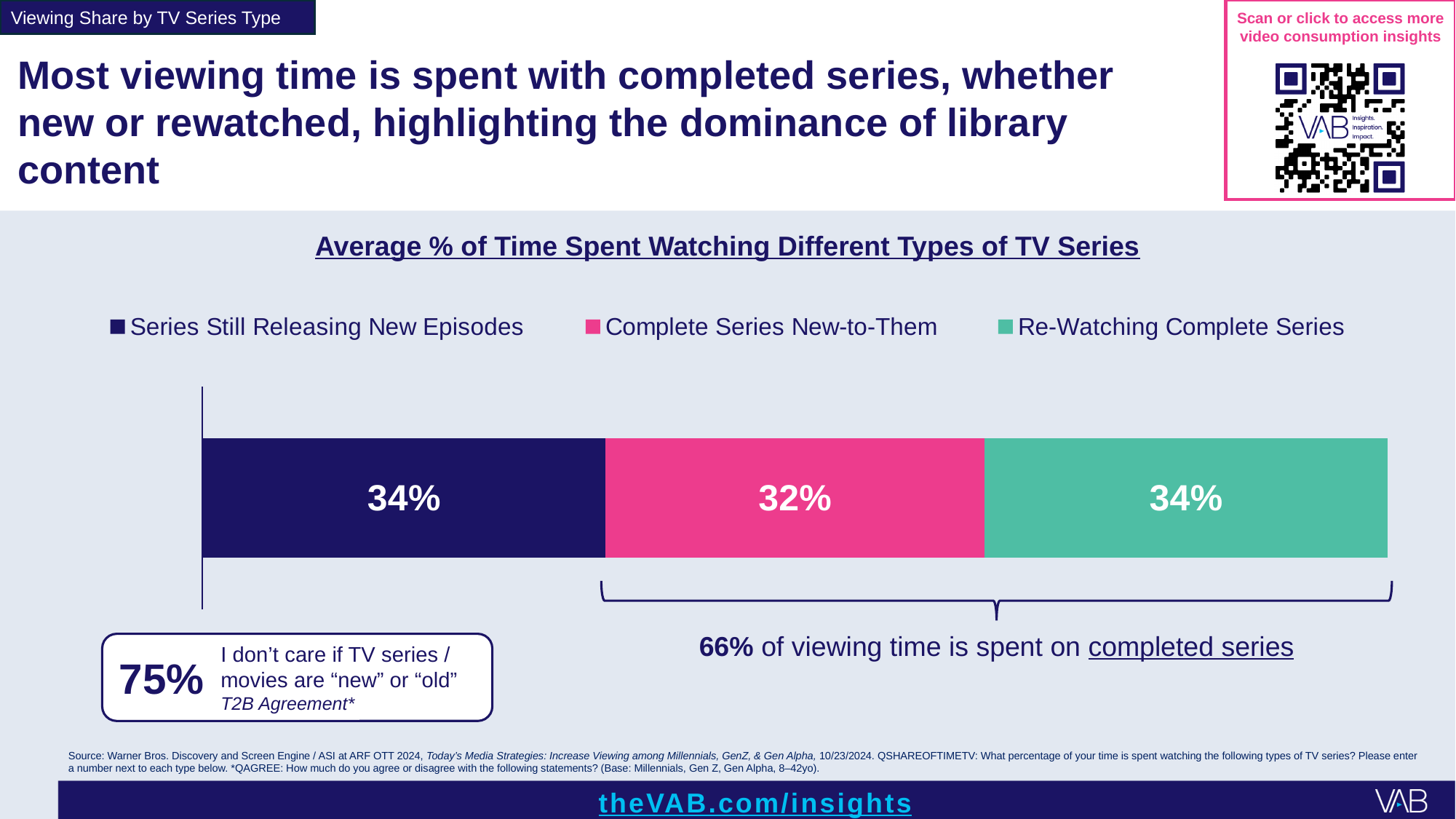
What is the total of the three segments in the stacked bar? 100% What kind of chart is shown on the slide? Stacked bar chart Which legend entry is shown in pink? Complete Series New-to-Them What is the value for Re-Watching Complete Series? 34% What is the difference between the value for Series Still Releasing New Episodes and the value for Complete Series New-to-Them? 2 percentage points Which is larger: the value for Re-Watching Complete Series or the value for Complete Series New-to-Them? Re-Watching Complete Series How many series does the legend list? 3 What is the value for Complete Series New-to-Them? 32% What is the title of the chart? Average % of Time Spent Watching Different Types of TV Series Which series type has the lowest share of viewing time? Complete Series New-to-Them What is the value for Series Still Releasing New Episodes? 34% What is the combined value of Complete Series New-to-Them and Re-Watching Complete Series? 66%